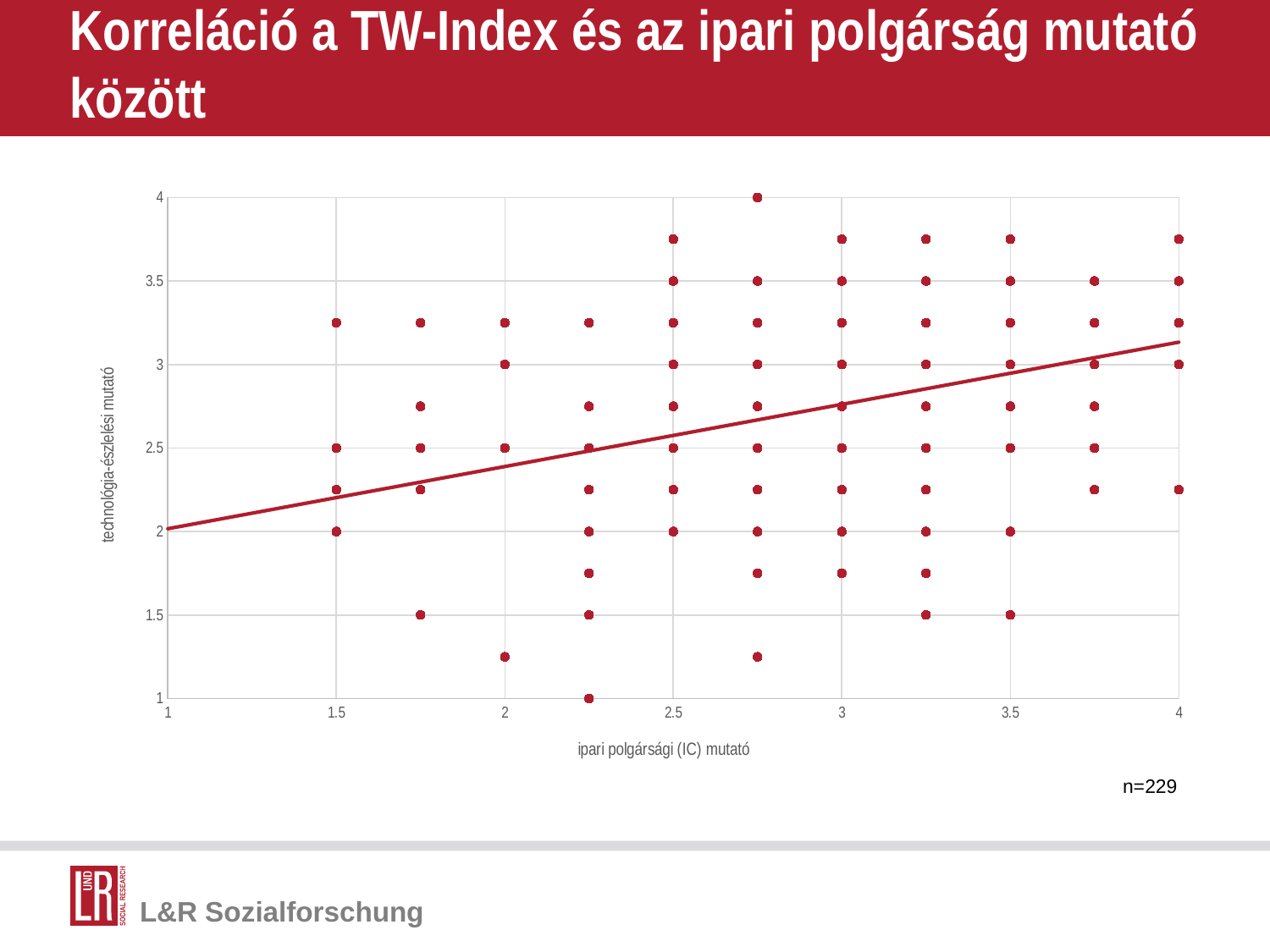
What is the highest technológia-észlelési mutató value reached by any point? 4 Does the trend line rise or fall as the ipari polgársági (IC) mutató increases? rises Is the trend line value at ipari polgársági (IC) mutató = 3.5 greater or less than 2.5? greater What is the maximum value shown on the x axis? 4 What is the lowest technológia-észlelési mutató value reached by any point? 1 At which ipari polgársági (IC) mutató value does the point with the lowest technológia-észlelési mutató (1) appear? 2.25 What kind of chart is shown on the slide? scatter plot What is the label of the x axis? ipari polgársági (IC) mutató What is the title of the chart? Korreláció a TW-Index és az ipari polgárság mutató között At which ipari polgársági (IC) mutató value does the point with the highest technológia-észlelési mutató (4) appear? 2.75 What is the minimum value shown on the y axis? 1 Is the trend line value at ipari polgársági (IC) mutató = 2.5 greater or less than 3? less